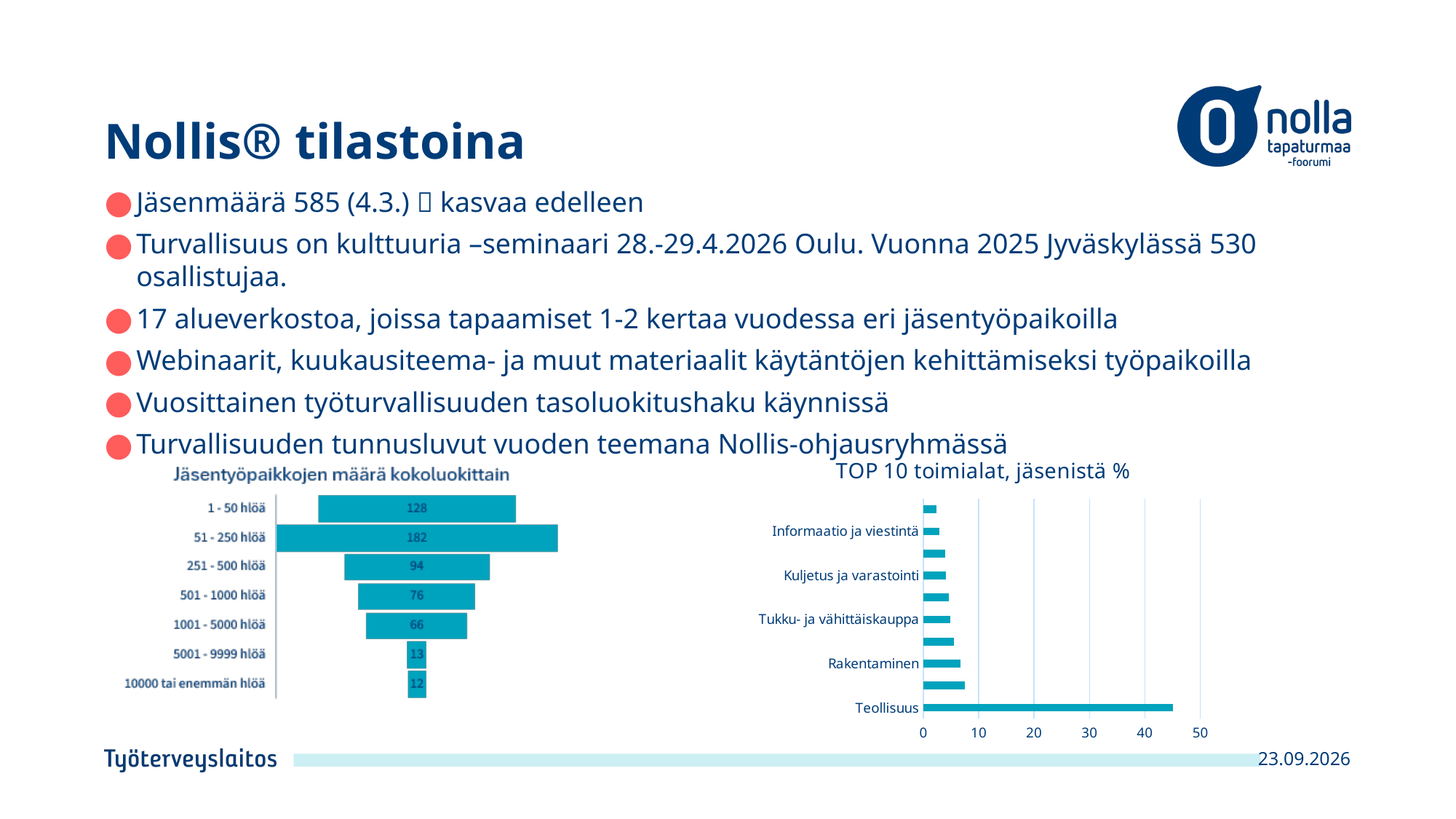
In the chart 'Jäsentyöpaikkojen määrä kokoluokittain', which size category has the lowest value? 10000 tai enemmän hlöä In the chart 'TOP 10 toimialat, jäsenistä %', is the value for Teollisuus greater or less than 40? greater In the chart 'Jäsentyöpaikkojen määrä kokoluokittain', what is the value for '1001 - 5000 hlöä'? 66 In the chart 'Jäsentyöpaikkojen määrä kokoluokittain', what is the value for '1 - 50 hlöä'? 128 In the chart 'Jäsentyöpaikkojen määrä kokoluokittain', which size category has the highest value? 51 - 250 hlöä In the chart 'Jäsentyöpaikkojen määrä kokoluokittain', which is larger: '251 - 500 hlöä' or '501 - 1000 hlöä'? 251 - 500 hlöä In the chart 'Jäsentyöpaikkojen määrä kokoluokittain', what is the difference between the values for '51 - 250 hlöä' and '1 - 50 hlöä'? 54 What kind of chart is 'TOP 10 toimialat, jäsenistä %'? bar chart In the chart 'TOP 10 toimialat, jäsenistä %', is the value for Rakentaminen greater or less than 10? less In the chart 'Jäsentyöpaikkojen määrä kokoluokittain', what is the value for '51 - 250 hlöä'? 182 In the chart 'TOP 10 toimialat, jäsenistä %', which industry has the highest value? Teollisuus In the chart 'Jäsentyöpaikkojen määrä kokoluokittain', how many size categories are shown? 7